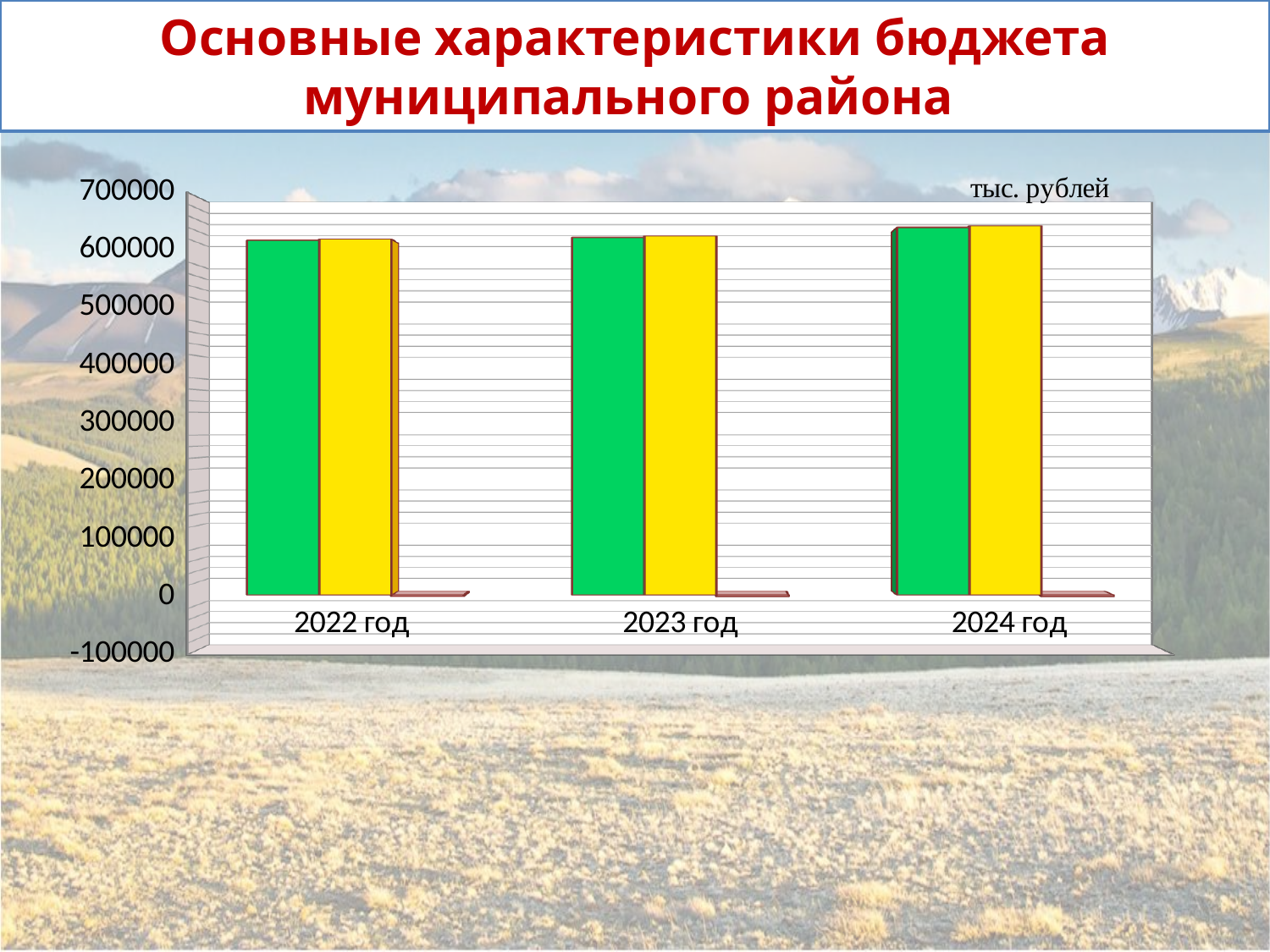
What is the title of the slide containing the chart? Основные характеристики бюджета муниципального района Is the value of the green bar for 2022 год greater or less than 500000? greater What unit of measurement is indicated in the top right corner of the chart? тыс. рублей Is the value of the green bar for 2024 год greater or less than 600000? greater Is the value of the yellow bar for 2023 год greater or less than 700000? less Do the green bars rise or fall from 2022 год to 2024 год? rise What is the lowest value shown on the vertical axis of the chart? -100000 Which year has the tallest green bar? 2024 год What kind of chart is shown on the slide? bar chart How many year categories are shown on the x axis of the chart? 3